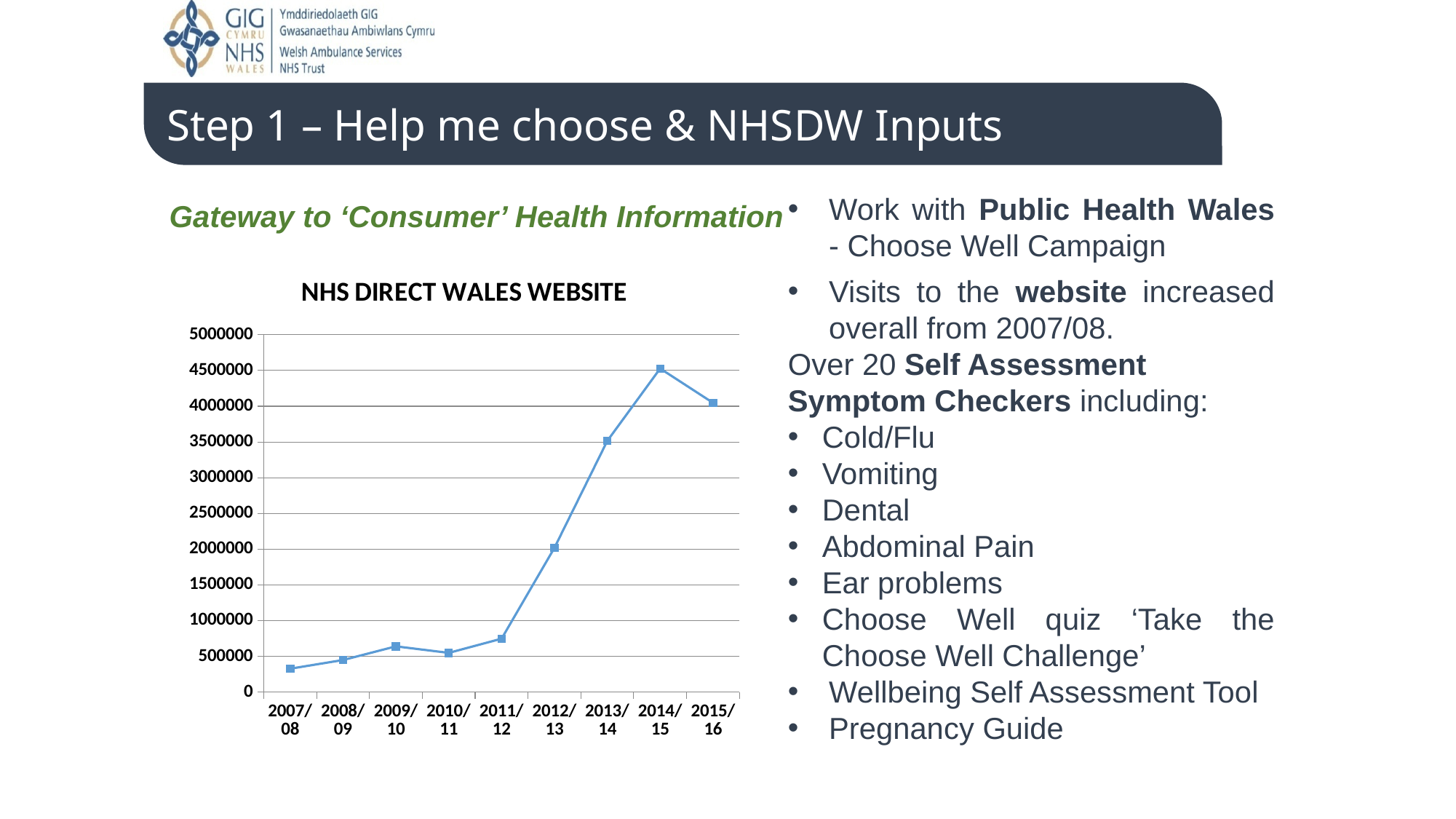
Which is larger, the value for 2013/14 or the value for 2015/16? 2015/16 Which year has the lowest value in the chart? 2007/08 Is the value for 2014/15 greater or less than 4000000? greater Is the value for 2012/13 greater or less than 1500000? greater How many years are plotted on the x axis of the chart? 9 Is the value for 2007/08 greater or less than 500000? less Which year has the highest value in the chart? 2014/15 Do the values generally rise or fall from 2007/08 to 2014/15? Rise What is the title of the chart? NHS DIRECT WALES WEBSITE Which is larger, the value for 2009/10 or the value for 2010/11? 2009/10 What kind of chart is shown on the slide? Line chart